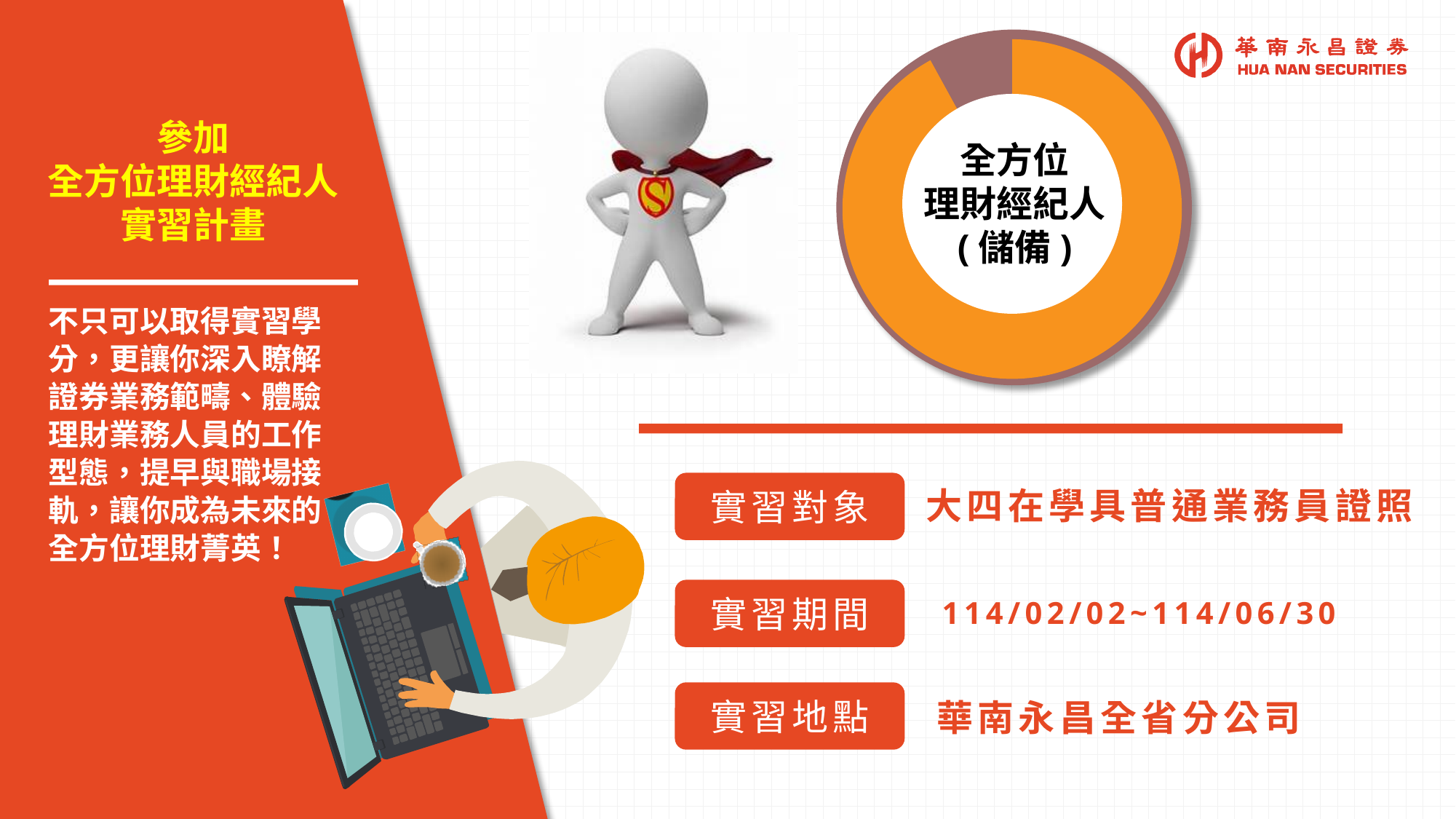
What kind of chart is shown in the upper right of the slide? Doughnut chart How many segments does the doughnut chart have? 2 Which segment of the doughnut chart is the smallest? The dark red segment Which segment of the doughnut chart is larger, the orange one or the dark red one? The orange one What colour is the largest segment of the doughnut chart? Orange What text is written in the centre of the doughnut chart? 全方位理財經紀人（儲備）